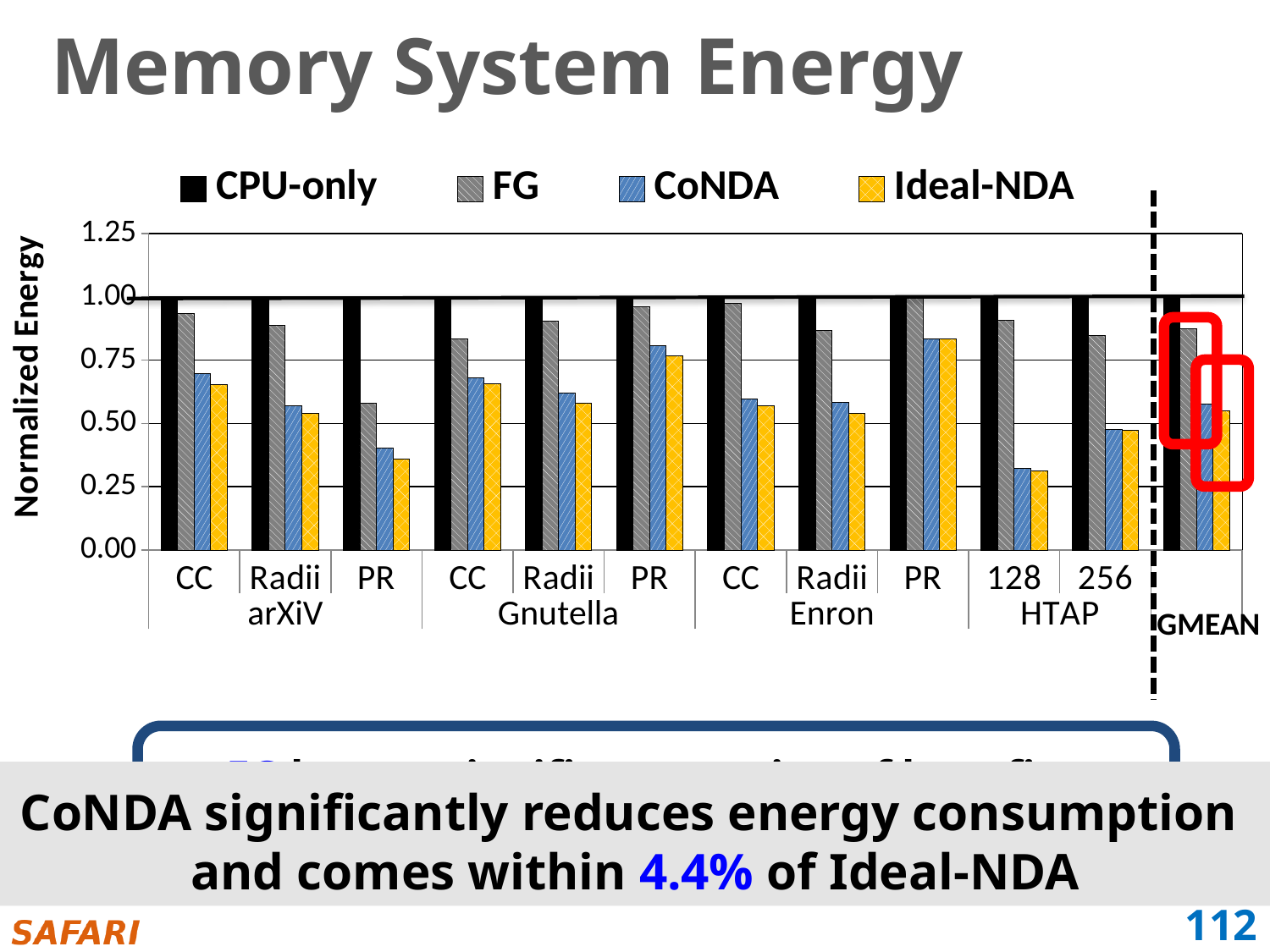
Is the CoNDA value for HTAP 128 greater or less than 0.50? less Is the CoNDA value for Enron PR greater or less than 0.75? greater Is the FG value for Gnutella CC greater or less than 0.75? greater What kind of chart is shown on the slide? bar chart How many series does the legend list? 4 What is the normalized energy value of the CPU-only bar for arXiV CC? 1.00 What is the label of the y axis? Normalized Energy How many categories are plotted along the x axis, including GMEAN? 12 Which category has the lowest CoNDA bar? HTAP 128 Which is larger, the CoNDA value for arXiV CC or the CoNDA value for arXiV PR? arXiV CC